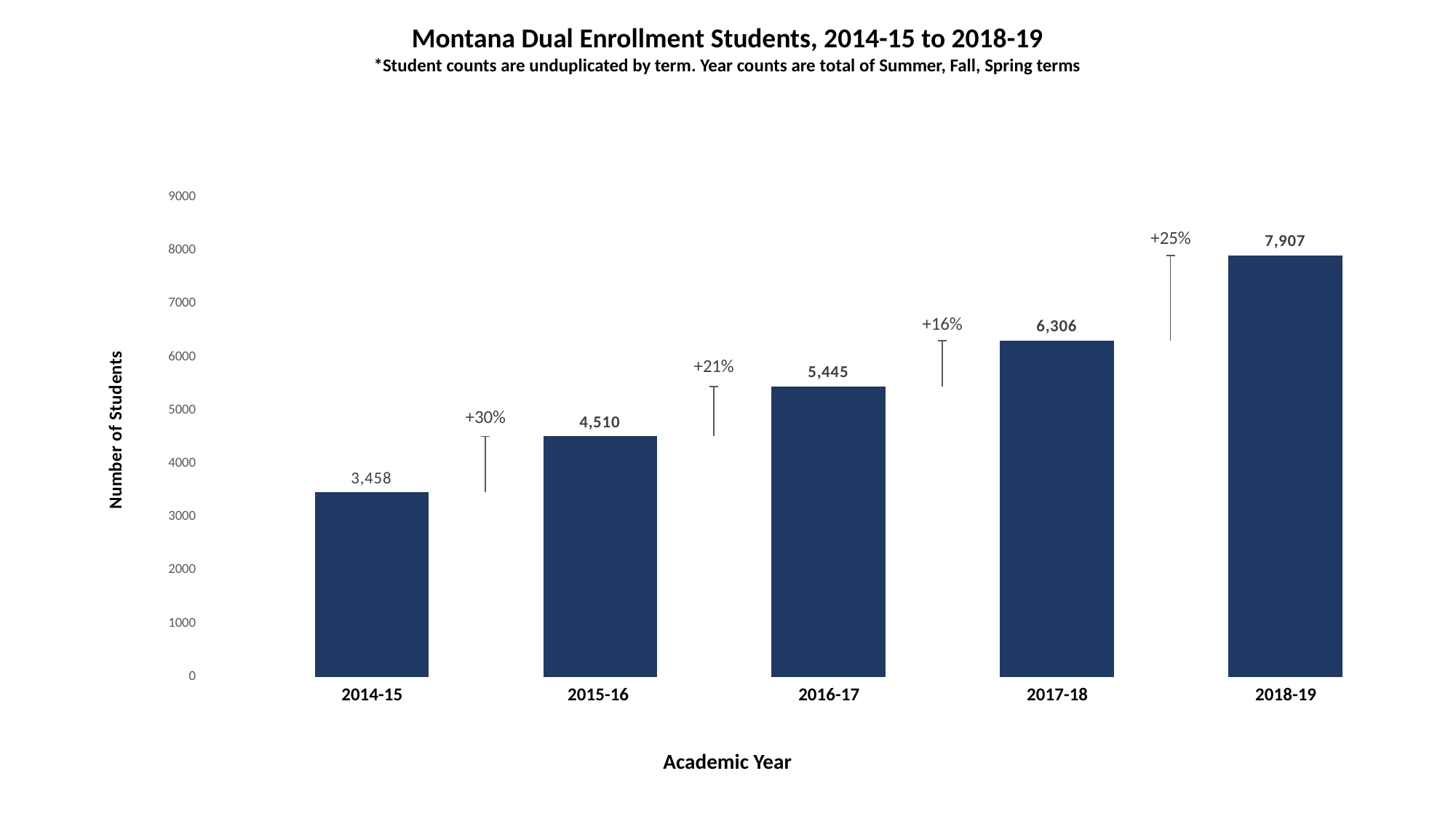
Which academic year has the highest number of students? 2018-19 How many academic years are shown on the chart? 5 What is the difference in student counts between 2017-18 and 2016-17? 861 Which academic year has the lowest number of students? 2014-15 Is the value for 2015-16 greater or less than 4000? greater What is the number of dual enrollment students in 2016-17? 5,445 What kind of chart is shown on the slide? Bar chart What is the difference in student counts between 2018-19 and 2014-15? 4,449 Which year has more students, 2015-16 or 2017-18? 2017-18 What is the number of dual enrollment students in 2014-15? 3,458 What is the number of dual enrollment students in 2018-19? 7,907 What percentage increase is labeled between 2017-18 and 2018-19? +25%